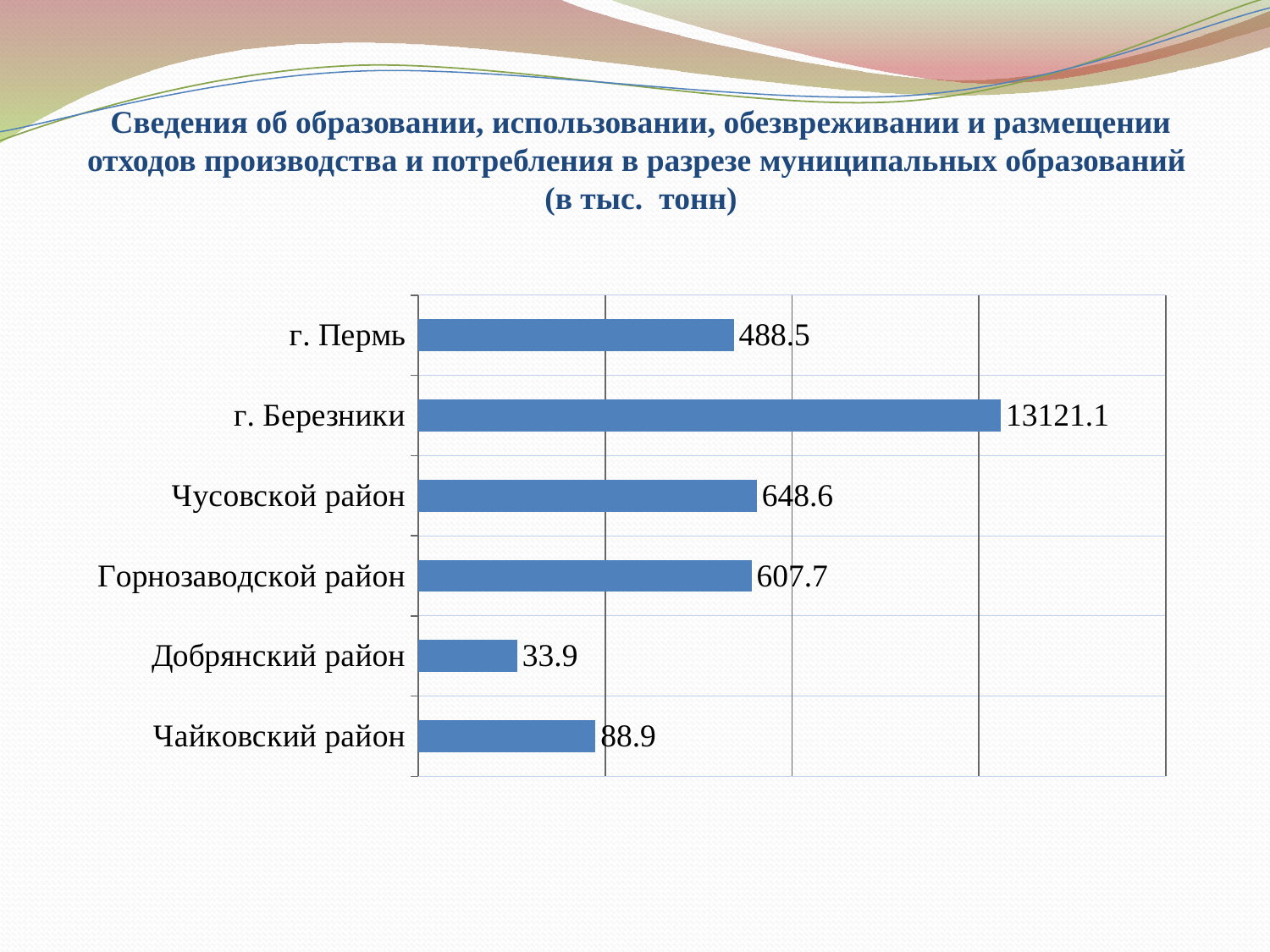
What is the difference between the values for Чусовской район and Горнозаводской район? 40.9 Which is larger, the value for Горнозаводской район or the value for г. Пермь? Горнозаводской район What is the value for Чусовской район? 648.6 What kind of chart is shown on the slide? bar chart What is the value for г. Березники? 13121.1 What is the difference between the values for Чайковский район and Добрянский район? 55.0 What is the value for Добрянский район? 33.9 Which category has the highest value? г. Березники What unit is stated in the chart title? тыс. тонн How many categories are shown in the chart? 6 What is the value for г. Пермь? 488.5 Which category has the lowest value? Добрянский район